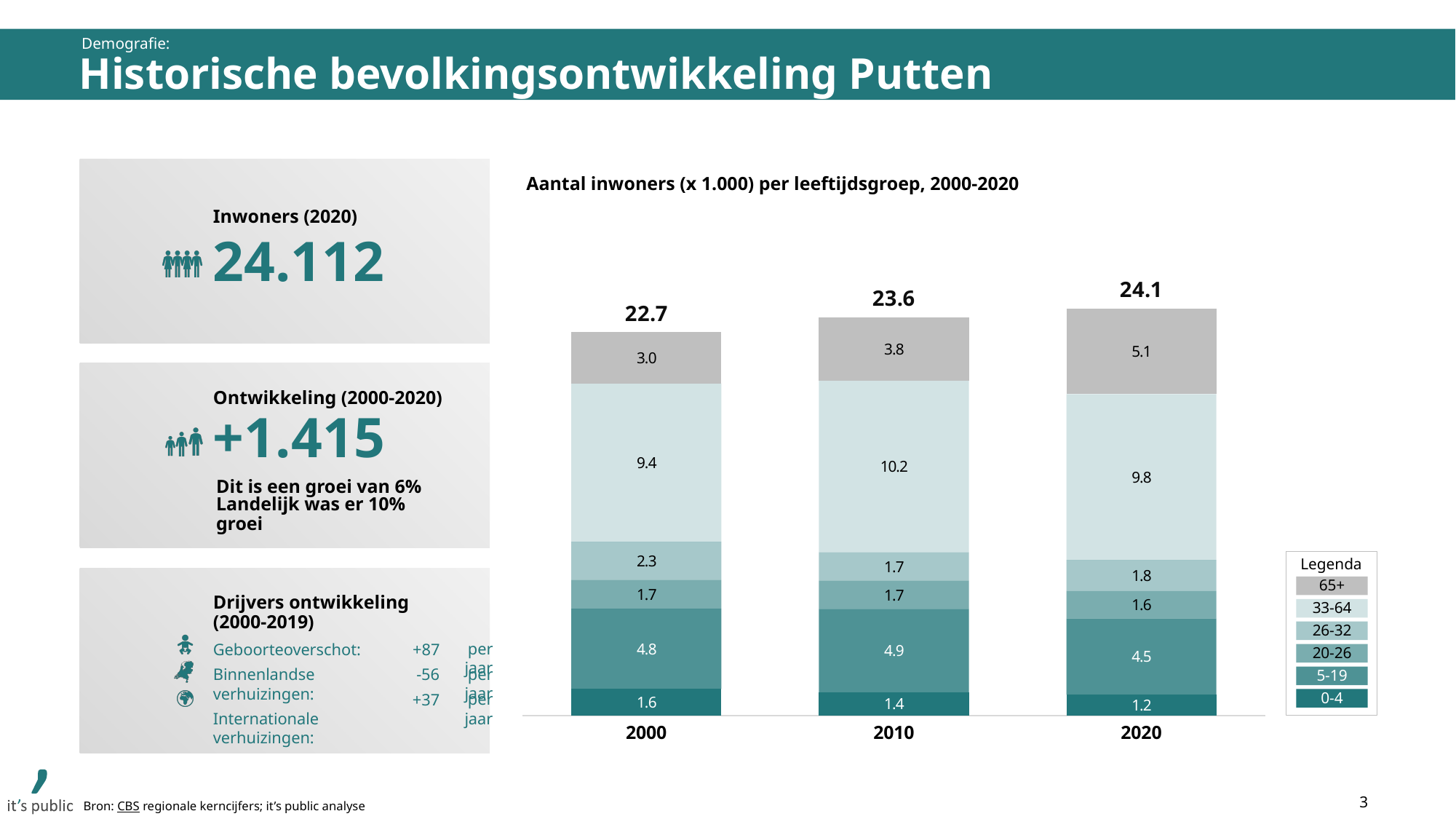
How many years are shown on the x axis? 3 Which is larger: the 5-19 value in 2010 or the 5-19 value in 2020? 2010 What is the value for the 33-64 age group in 2010? 10.2 Which year has the lowest value for the 0-4 age group? 2020 What is the difference between the 65+ values for 2020 and 2000? 2.1 Which year has the highest total number of inhabitants? 2020 What is the total of the stacked bar for 2010? 23.6 Do the values for the 65+ age group rise or fall from 2000 to 2020? Rise What kind of chart is shown on the slide? Stacked bar chart What is the value for the 65+ age group in 2020? 5.1 How many age groups does the legend list? 6 What is the value for the 0-4 age group in 2000? 1.6